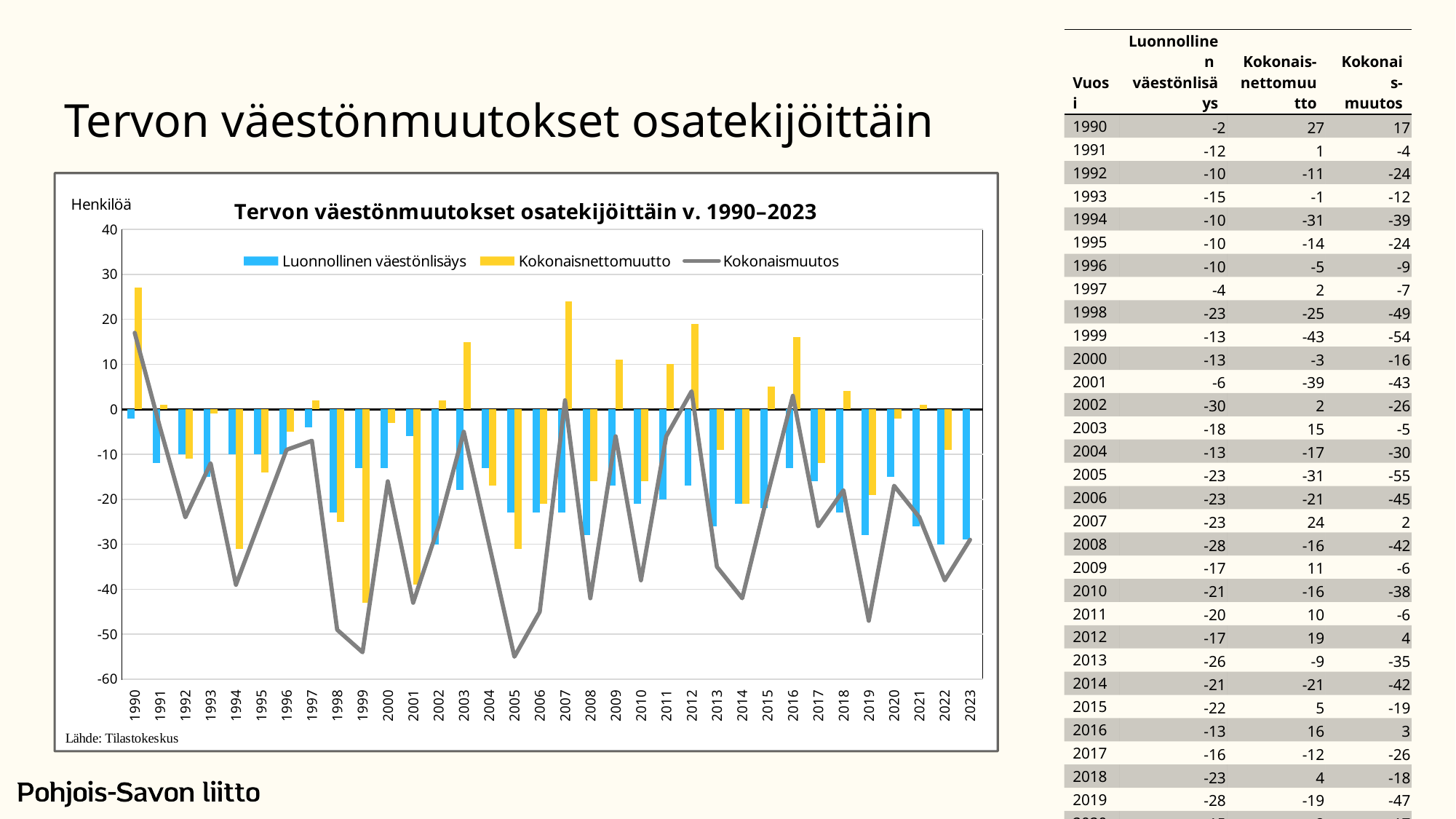
What is the Kokonaisnettomuutto value for 1990? 27 In which year is Kokonaisnettomuutto lowest? 1999 What is the Kokonaismuutos value for 2007? 2 How many series does the chart legend list? 3 Is the Kokonaismuutos value for 1998 greater or less than -40? less What is the difference between the Kokonaismuutos values for 1990 and 1991? 21 Which year has the larger Kokonaisnettomuutto value, 2003 or 2009? 2003 What is the Luonnollinen väestönlisäys value for 2002? -30 What is the title of the chart? Tervon väestönmuutokset osatekijöittäin v. 1990–2023 In which year is Kokonaisnettomuutto highest? 1990 How many years are shown on the x axis of the chart? 34 What kind of chart is shown on the slide? bar chart with a line